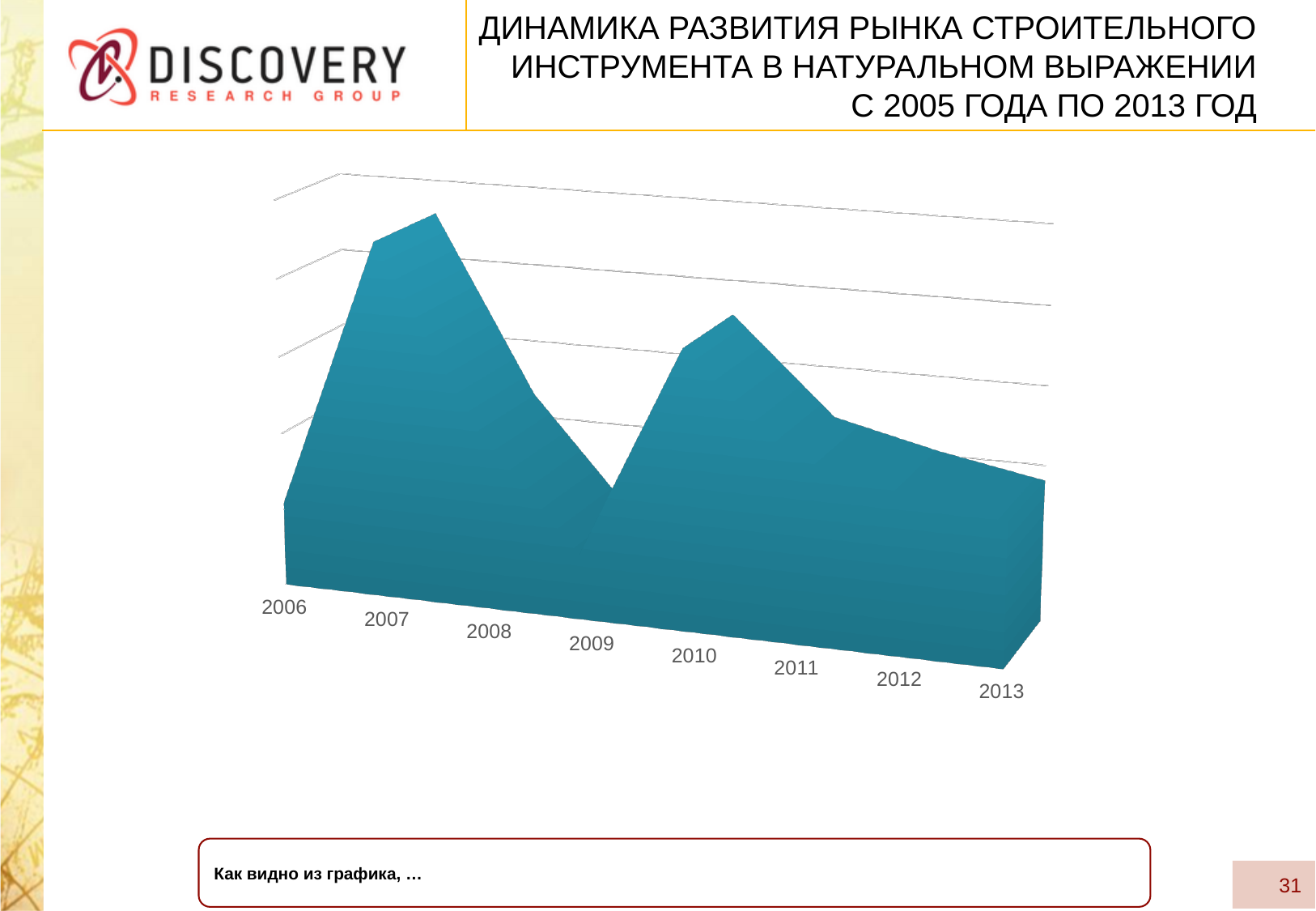
Which year has the highest value on the chart? 2007 Which is larger, the value for 2007 or the value for 2010? 2007 How many years are labelled on the x axis of the chart? 8 What is the first year labelled on the x axis of the chart? 2006 Does the value rise or fall from 2009 to 2010? rise Which is larger, the value for 2006 or the value for 2007? 2007 What is the last year labelled on the x axis of the chart? 2013 Does the value rise or fall from 2010 to 2013? fall Does the value rise or fall from 2007 to 2009? fall What kind of chart is shown on the slide? area chart Which is larger, the value for 2009 or the value for 2010? 2010